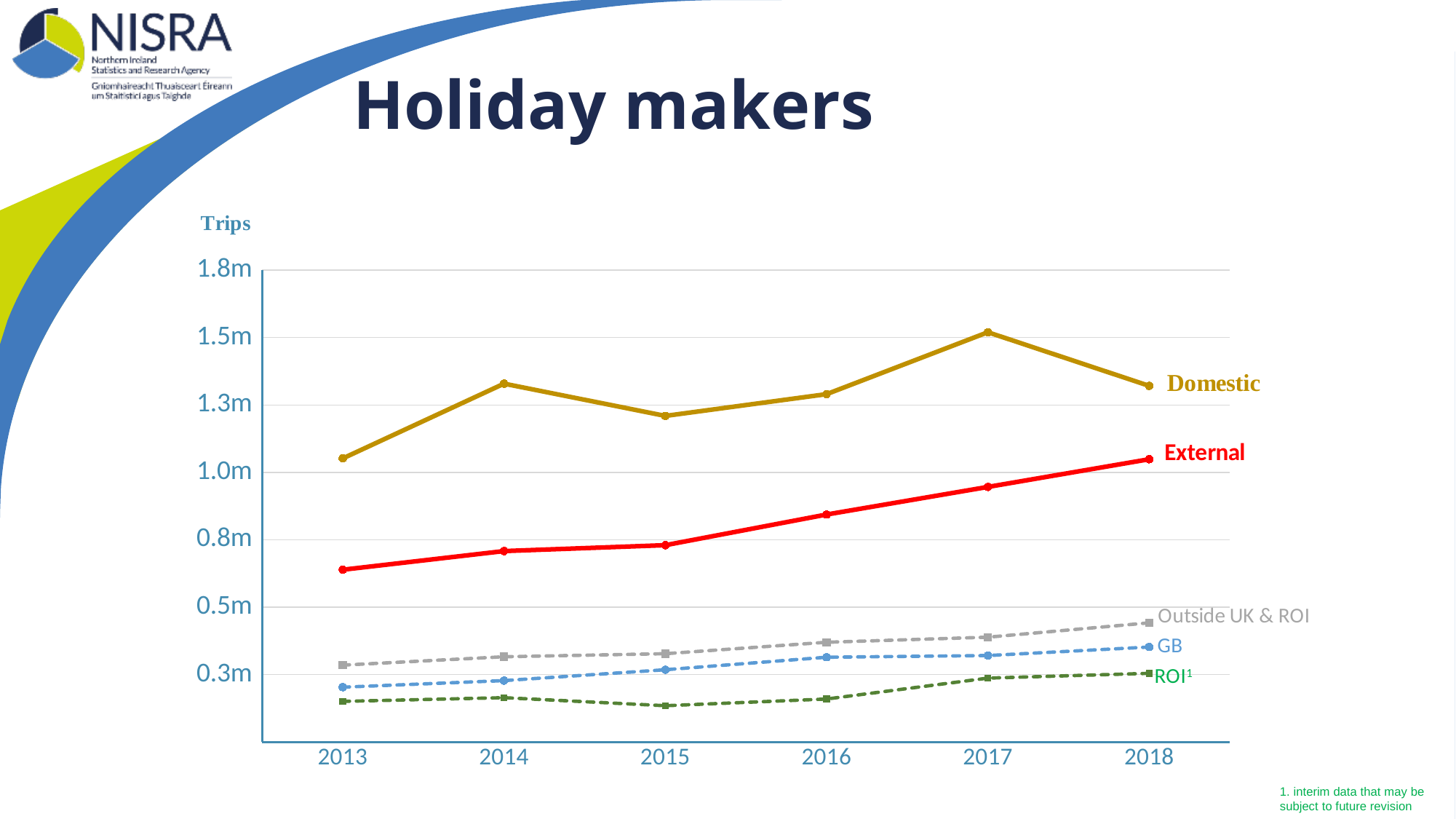
In which year is the Domestic series at its highest? 2017 What is the title of the slide? Holiday makers In which year is the Domestic series at its lowest? 2013 What kind of chart is shown on the slide? line chart In which year is the ROI series at its lowest? 2015 Which series has the lowest values across all years? ROI How many series are labelled on the chart? 5 Is the value for Domestic in 2013 greater or less than 1.0m? greater How many years are plotted along the x axis? 6 Is the value for External in 2013 greater or less than 0.8m? less In 2018, which is larger: Domestic or External? Domestic Does the External series rise or fall from 2013 to 2018? rise